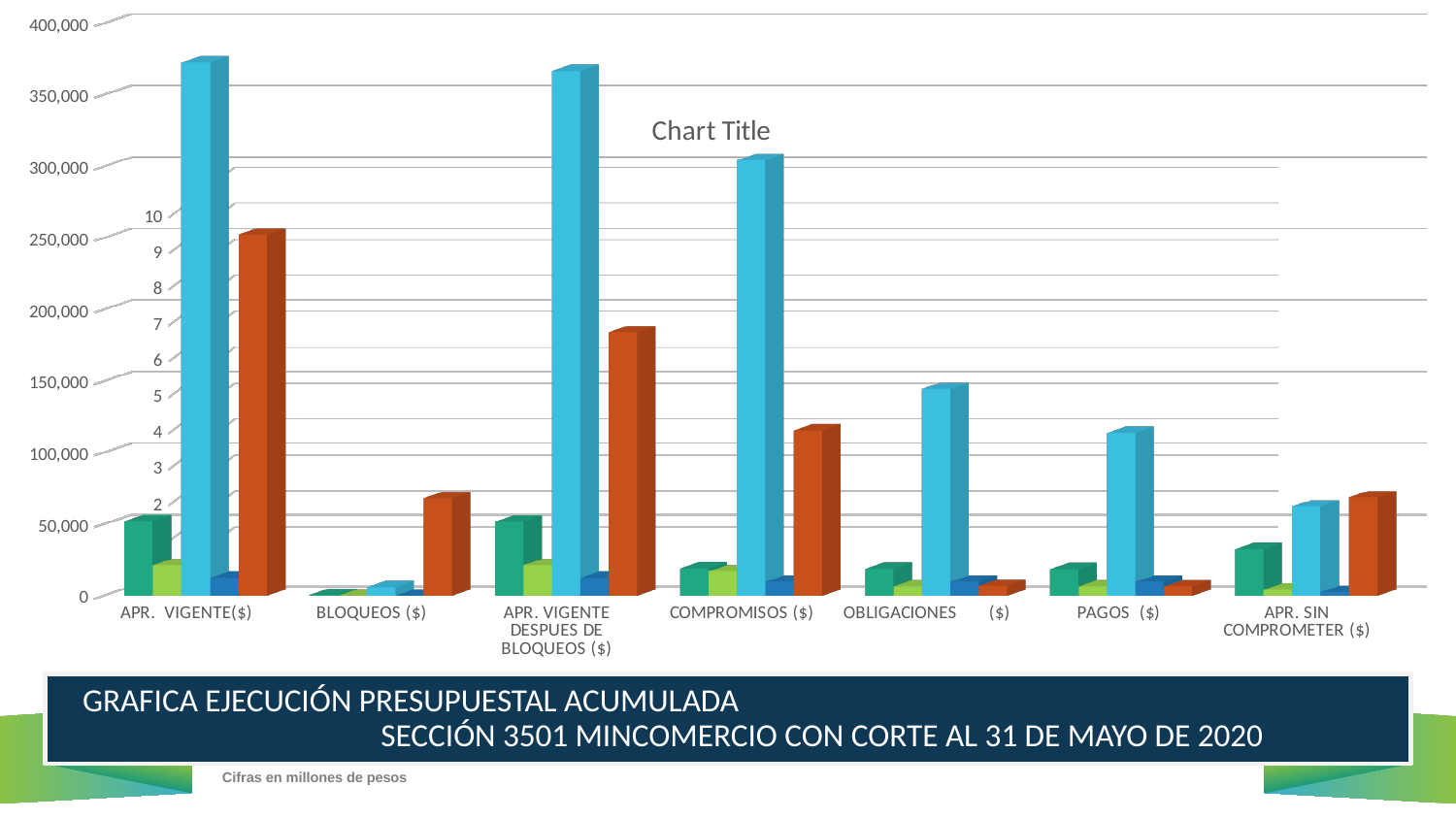
What title is displayed inside the chart area? Chart Title Is the value of the orange bar for APR. VIGENTE($) greater or less than 200,000? greater Is the value of the light blue bar for APR. VIGENTE($) greater or less than 350,000? greater What kind of chart is shown on the slide? bar chart Is the value of the light blue bar for PAGOS ($) greater or less than 150,000? less Which is larger: the light blue bar for COMPROMISOS ($) or the light blue bar for OBLIGACIONES ($)? COMPROMISOS ($) Which category has the lowest light blue bar? BLOQUEOS ($) How many bars are plotted for each category in the chart? 5 How many categories are shown along the x axis of the chart? 7